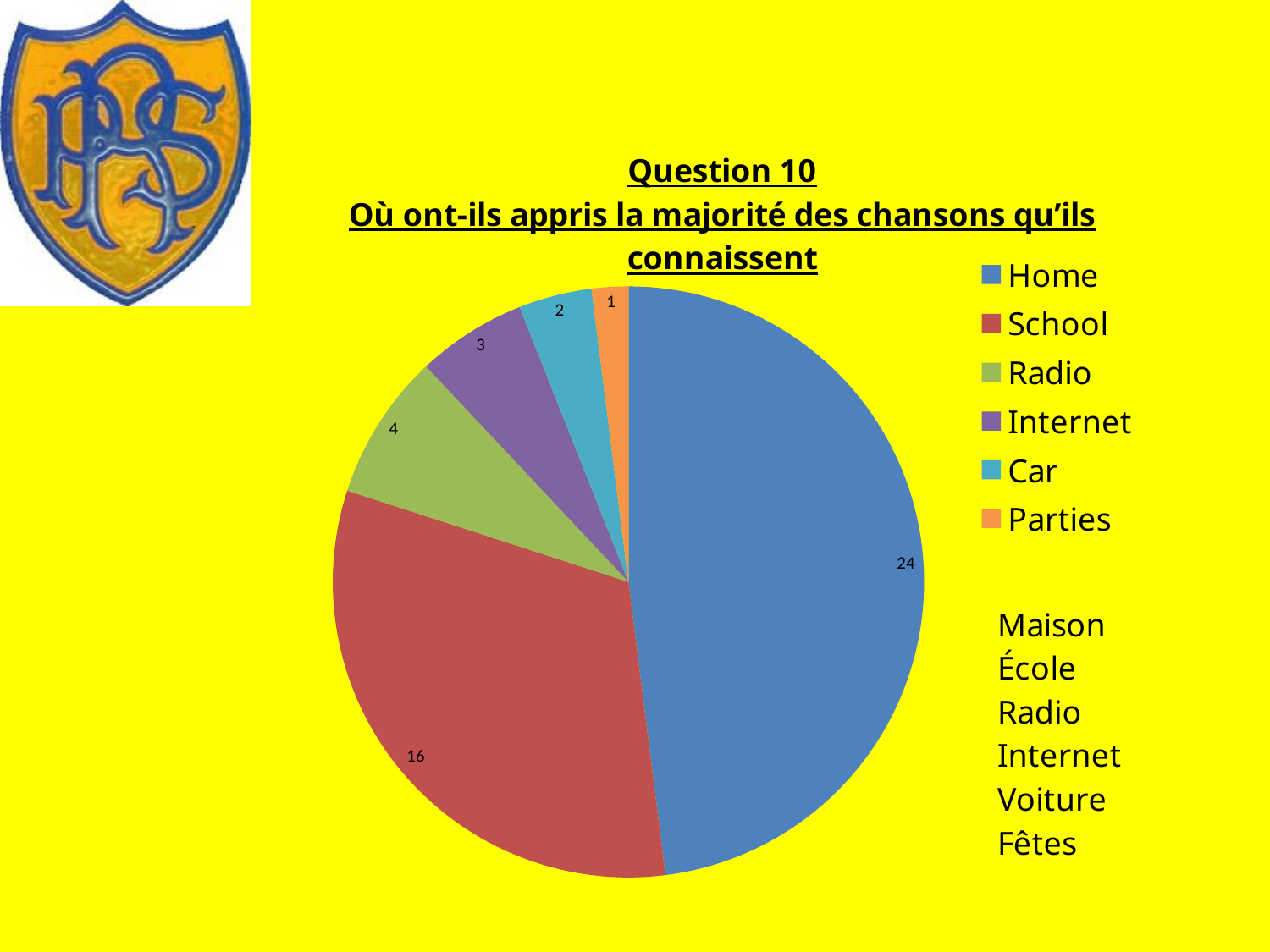
What kind of chart is shown on the slide? pie chart Which category has the smallest slice of the pie chart? Parties What is the value for School in the pie chart? 16 What colour is the School slice in the pie chart? red What share of the pie does the Home slice represent? 48% What is the value for Home in the pie chart? 24 Which category has the largest slice of the pie chart? Home Which is larger, the value for Internet or the value for Car? Internet What is the difference between the values for Home and School? 8 How many categories does the pie chart have? 6 What is the value for Car in the pie chart? 2 What is the value for Radio in the pie chart? 4